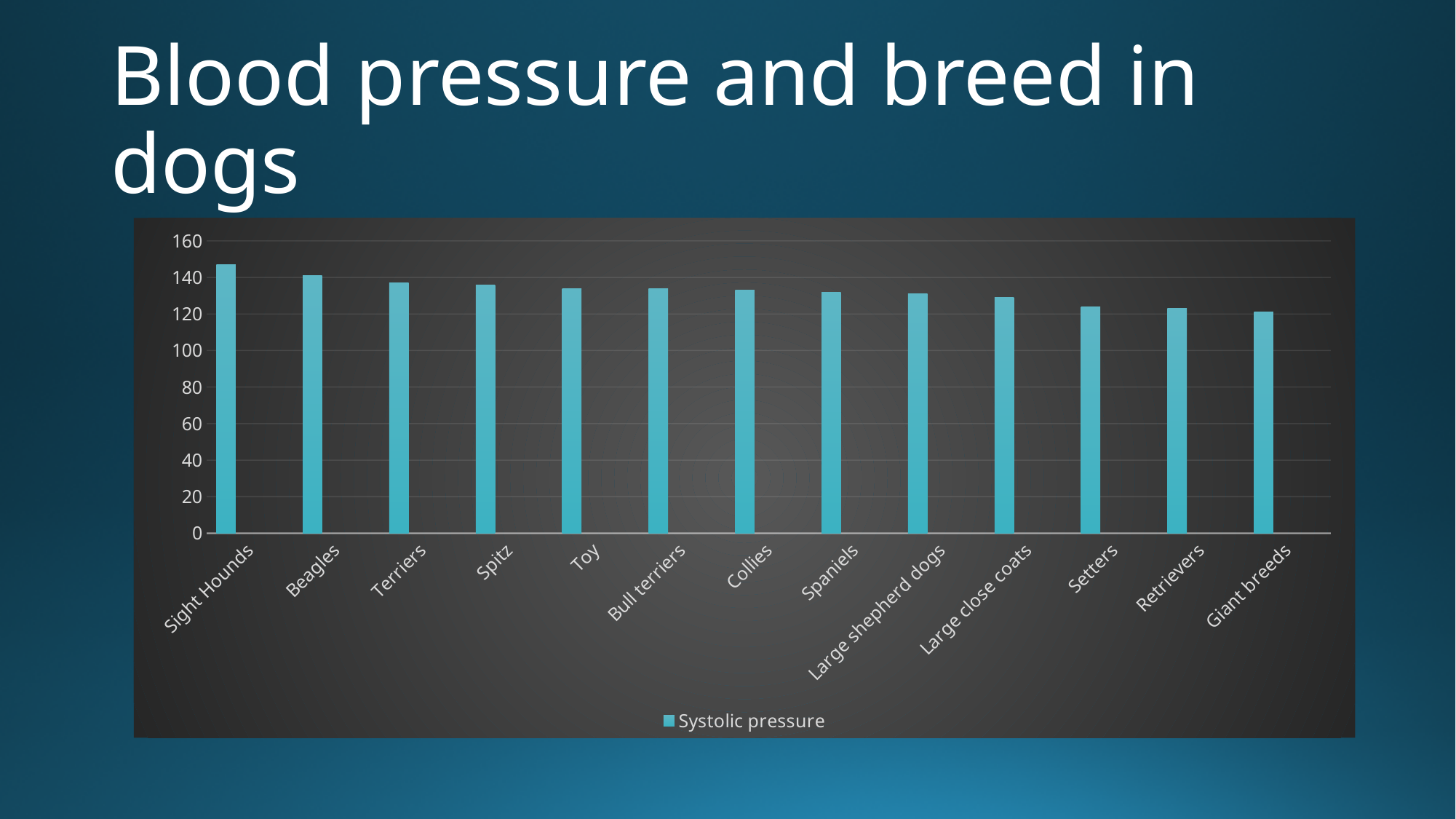
How many dog breed categories are plotted on the chart? 13 What series name is shown in the chart legend? Systolic pressure Is the systolic pressure for Setters greater or less than 120? greater Is the systolic pressure for Sight Hounds greater or less than 140? greater Is the systolic pressure for Giant breeds greater or less than 140? less How many series does the legend list? 1 Which has a higher systolic pressure, Retrievers or Terriers? Terriers Which breed category has the highest systolic pressure? Sight Hounds Do the systolic pressure values rise or fall from left to right along the x axis? fall What kind of chart is shown on the slide? bar chart Which has a higher systolic pressure, Beagles or Setters? Beagles Which breed category has the lowest systolic pressure? Giant breeds